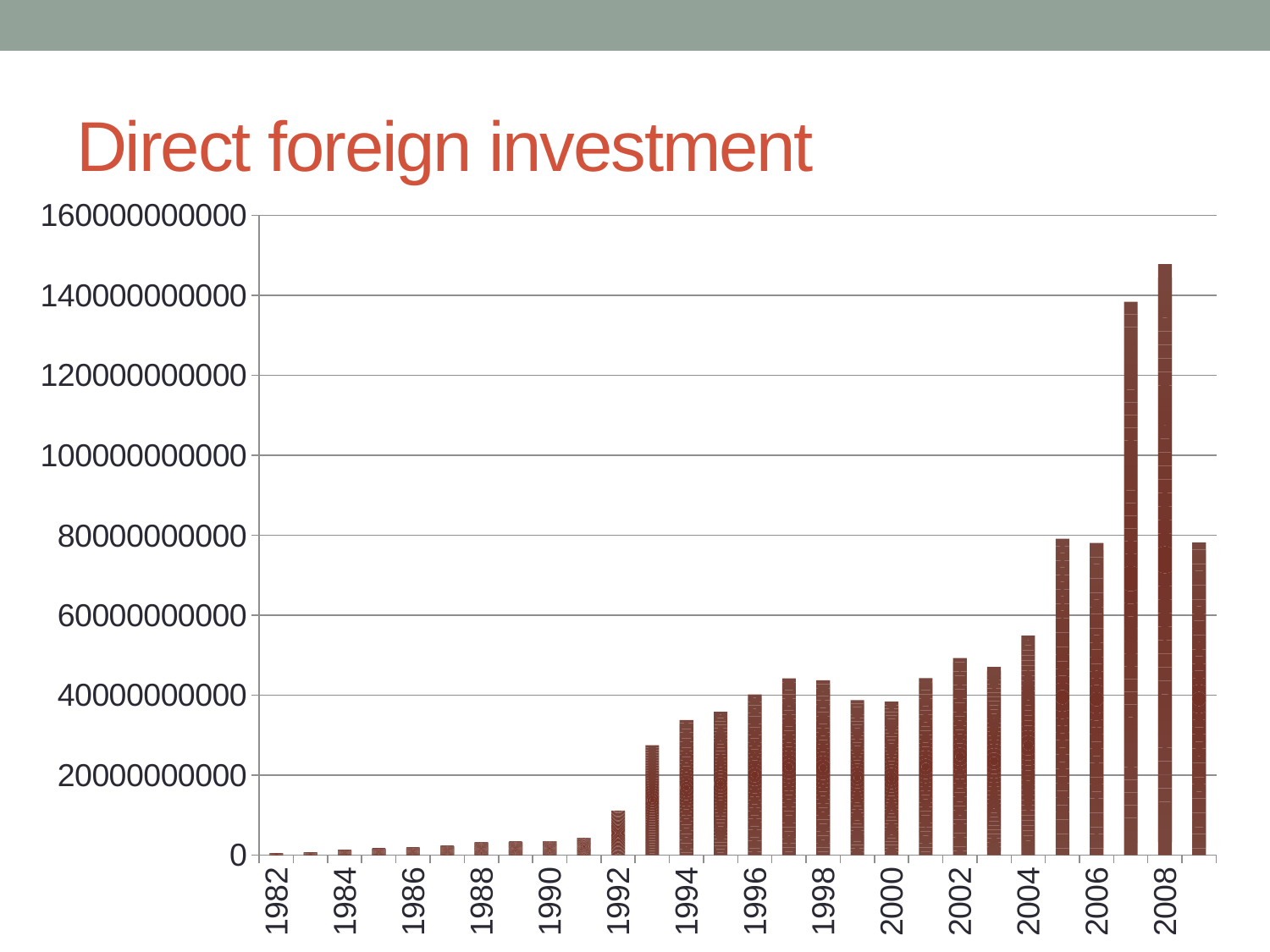
Which year has the lowest direct foreign investment? 1982 Is the value for 2004 greater or less than 60000000000? less Which year has the larger value, 2006 or 2008? 2008 What is the title of the chart? Direct foreign investment Do the values generally rise or fall from 1982 to 2008? rise What kind of chart is shown on the slide? bar chart Is the value for 2008 greater or less than 140000000000? greater Is the value for 2002 greater or less than 40000000000? greater Which year has the highest direct foreign investment? 2008 Which year has the larger value, 1992 or 1994? 1994